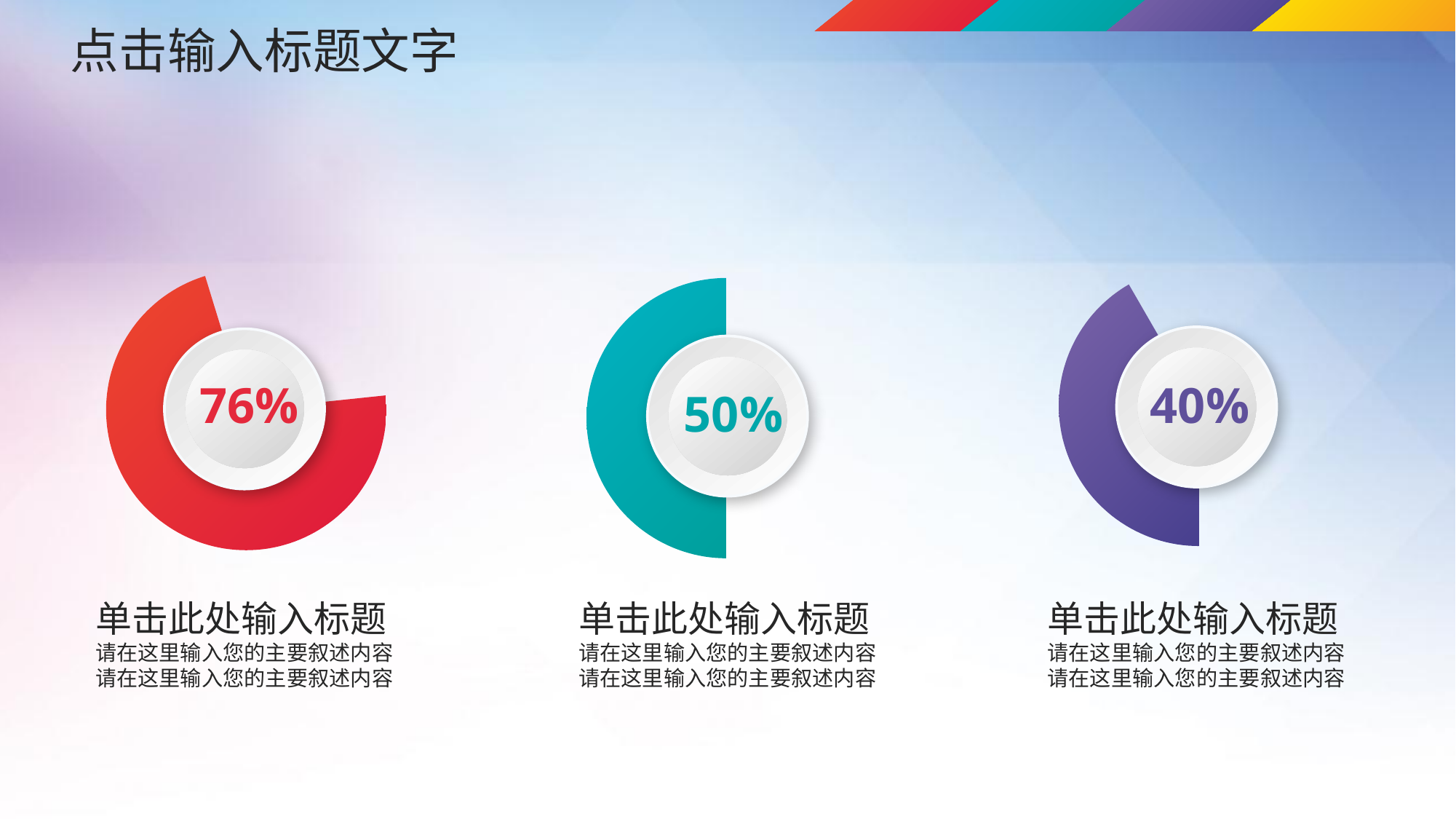
What is the difference between the value in the left chart and the value in the right chart? 36% What value is shown in the right chart? 40% Which is larger, the value in the left chart or the value in the middle chart? The left chart (76%) What colour is the ring of the right chart? Purple Which of the three charts shows the highest percentage? The left chart (76%) What is the difference between the value in the middle chart and the value in the right chart? 10% What value is shown in the middle chart? 50% What kind of chart is used to display the percentages on the slide? Donut (ring) chart How many ring charts are shown on the slide? 3 What value is shown in the left chart? 76% Which of the three charts shows the lowest percentage? The right chart (40%) What colour is the ring of the middle chart? Teal